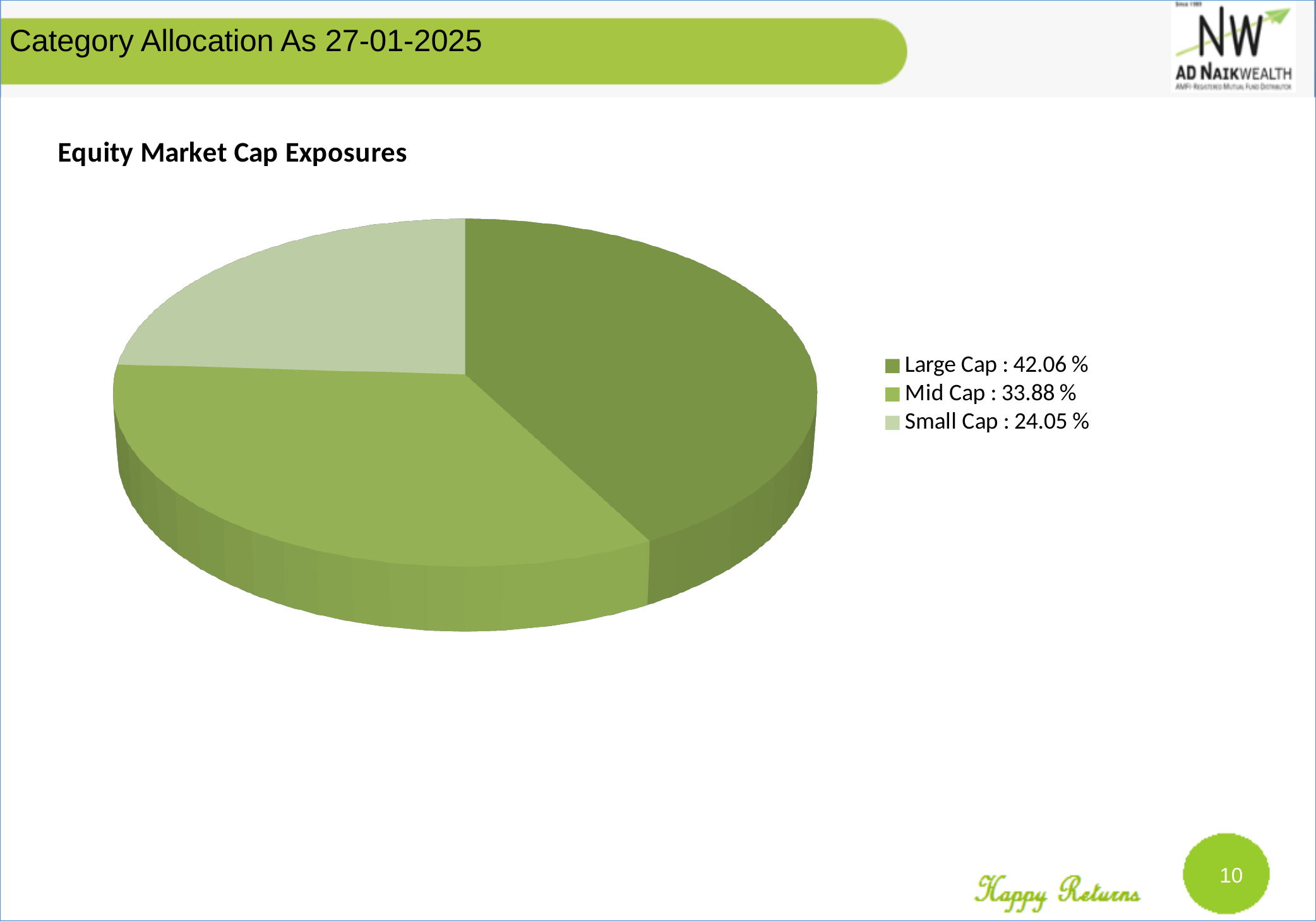
What is the share for Small Cap? 24.05 % What is the share for Large Cap? 42.06 % Which category is shown in the lightest green colour? Small Cap Which is larger, the Mid Cap share or the Small Cap share? Mid Cap What is the share for Mid Cap? 33.88 % How many categories does the pie chart show? 3 What kind of chart is shown on the slide? pie chart What is the title of the chart? Equity Market Cap Exposures Which category has the largest share of the pie? Large Cap Which category has the smallest share of the pie? Small Cap What is the difference between the Large Cap and Mid Cap shares? 8.18 % What is the difference between the Mid Cap and Small Cap shares? 9.83 %